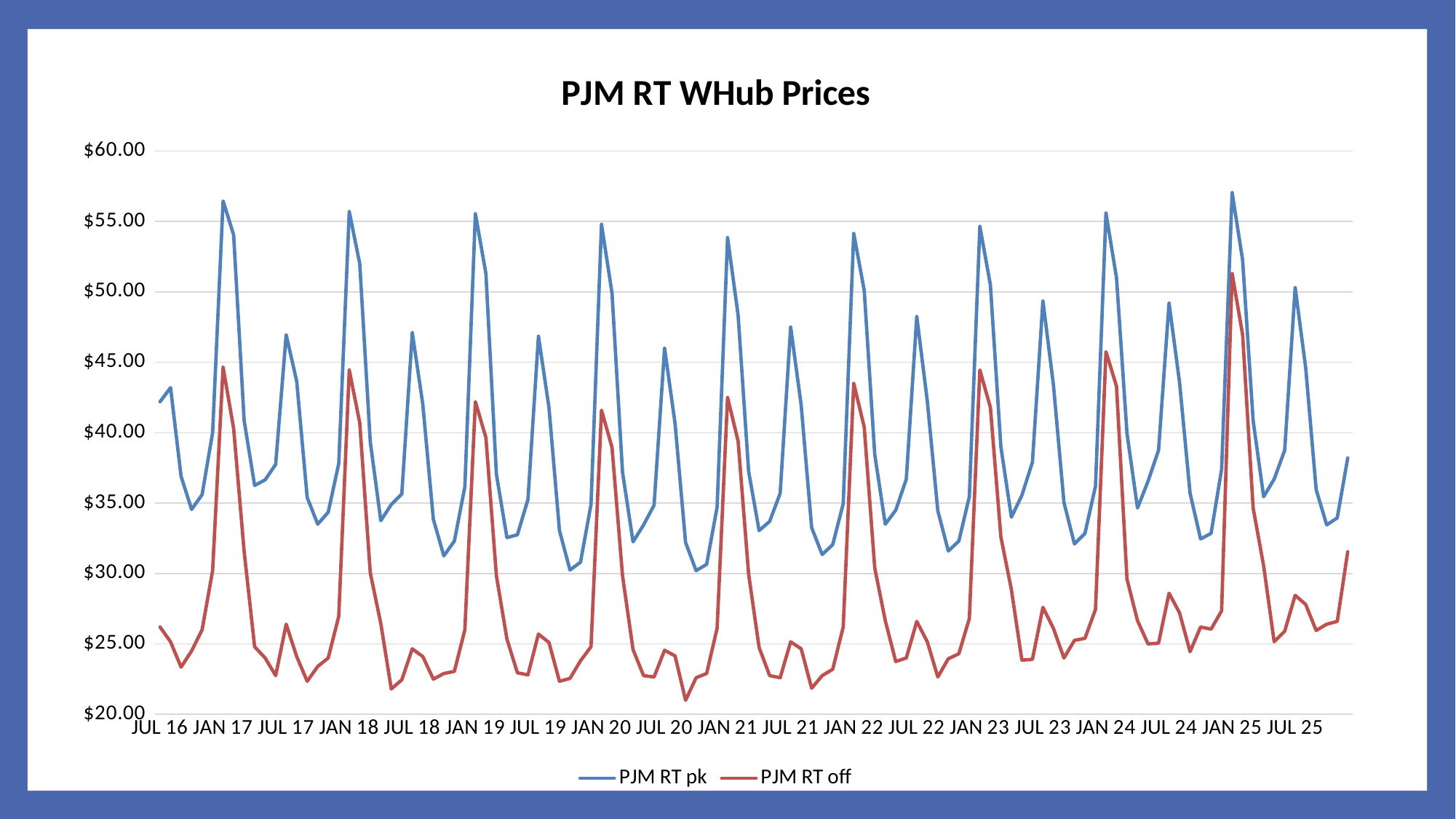
Which colour is used for the PJM RT off series? Red Is the value of PJM RT pk at JUL 16 greater or less than $45.00? less Is the value of PJM RT off at JAN 17 greater or less than $40.00? greater Is the value of PJM RT off at JUL 16 greater or less than $30.00? less Which series is higher at JAN 20, PJM RT pk or PJM RT off? PJM RT pk How many labelled tick marks are on the x axis? 19 What is the title of the chart? PJM RT WHub Prices How many series does the legend list? 2 What kind of chart is shown on the slide? Line chart At which x-axis label does the PJM RT off series reach its highest peak? JAN 25